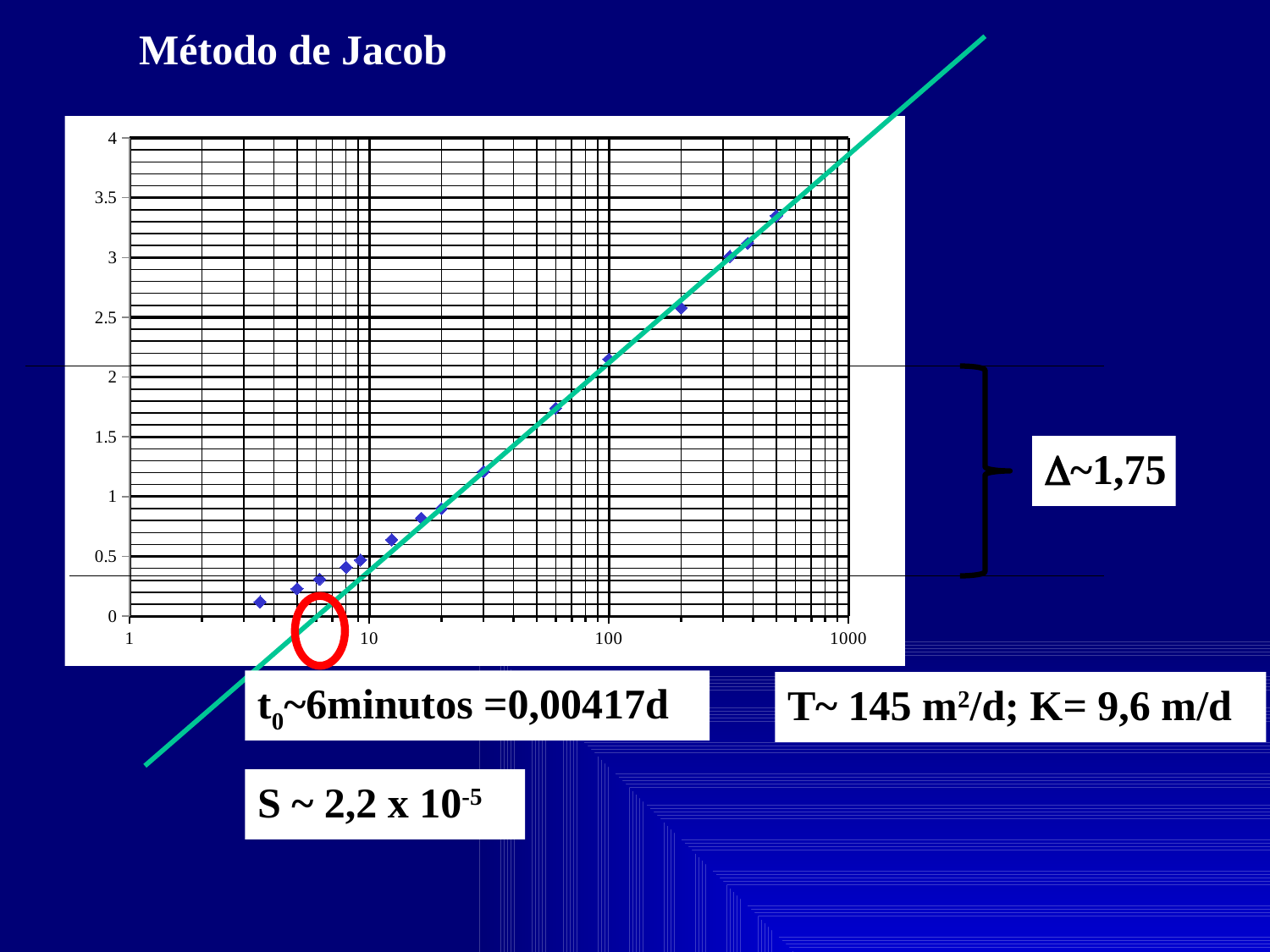
What kind of chart is shown on the slide? scatter chart Is the plotted value at x = 200 greater or less than 3? less What is the title of the slide containing the chart? Método de Jacob Is the plotted value at x = 500 greater or less than 3? greater Is the plotted value at x = 30 greater or less than 1? greater What is the highest tick label shown on the x axis? 1000 What is the highest tick label shown on the y axis? 4 How many data series are plotted on the chart? 1 What value of Δ is annotated next to the chart? Δ~1,75 Do the plotted values rise or fall as the x axis increases? rise